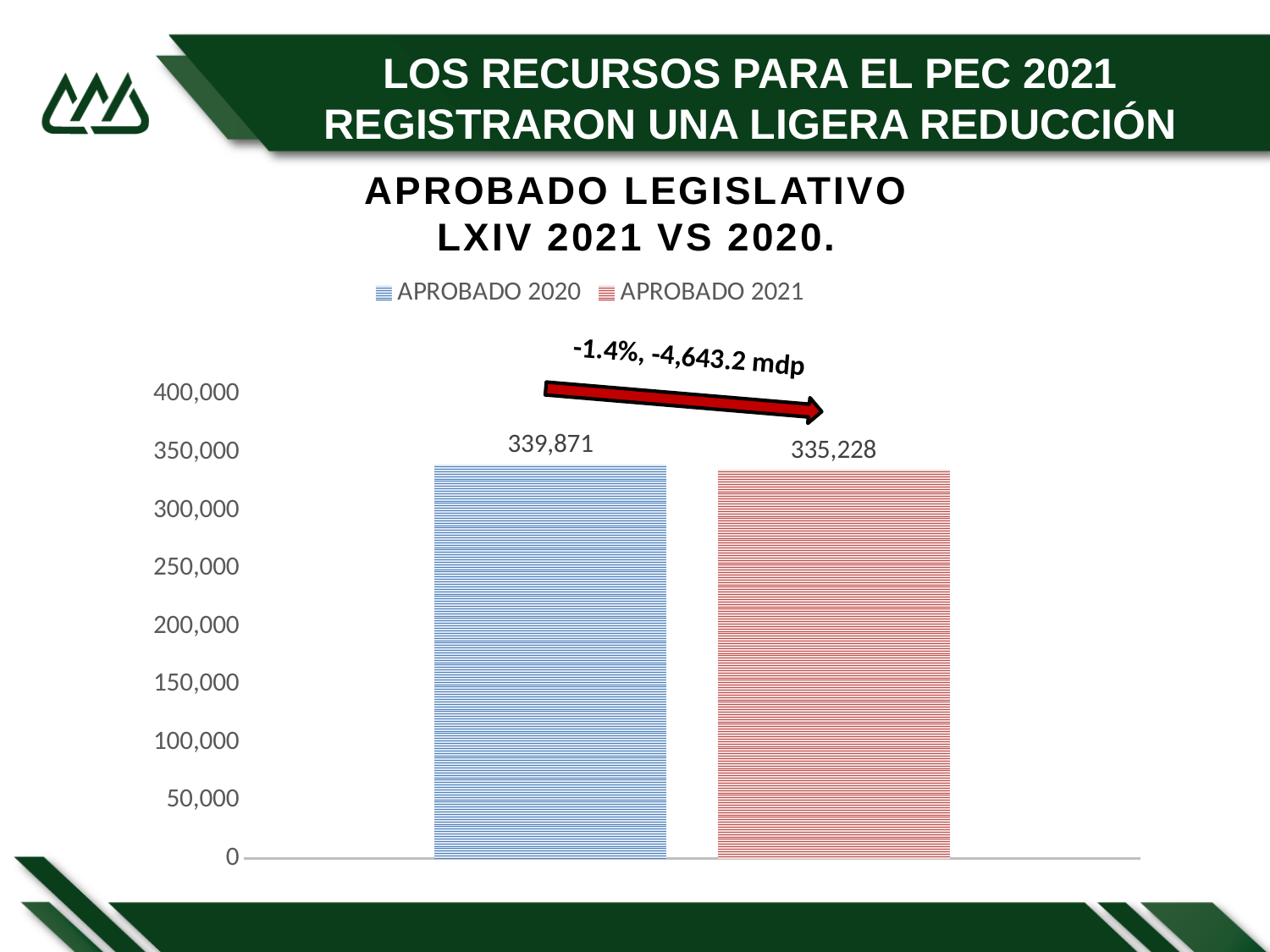
What is the value for APROBADO 2021? 335,228 What percentage change is annotated above the bars? -1.4% What is the title of the chart? APROBADO LEGISLATIVO LXIV 2021 VS 2020. Which series has the lowest value? APROBADO 2021 What kind of chart is shown? bar chart How many bars are plotted in the chart? 2 Is the value for APROBADO 2021 greater or less than 350,000? less Is the value for APROBADO 2020 greater or less than 300,000? greater Which series has the higher value, APROBADO 2020 or APROBADO 2021? APROBADO 2020 How many series does the legend list? 2 What is the value for APROBADO 2020? 339,871 What is the difference between the APROBADO 2020 and APROBADO 2021 values? 4,643